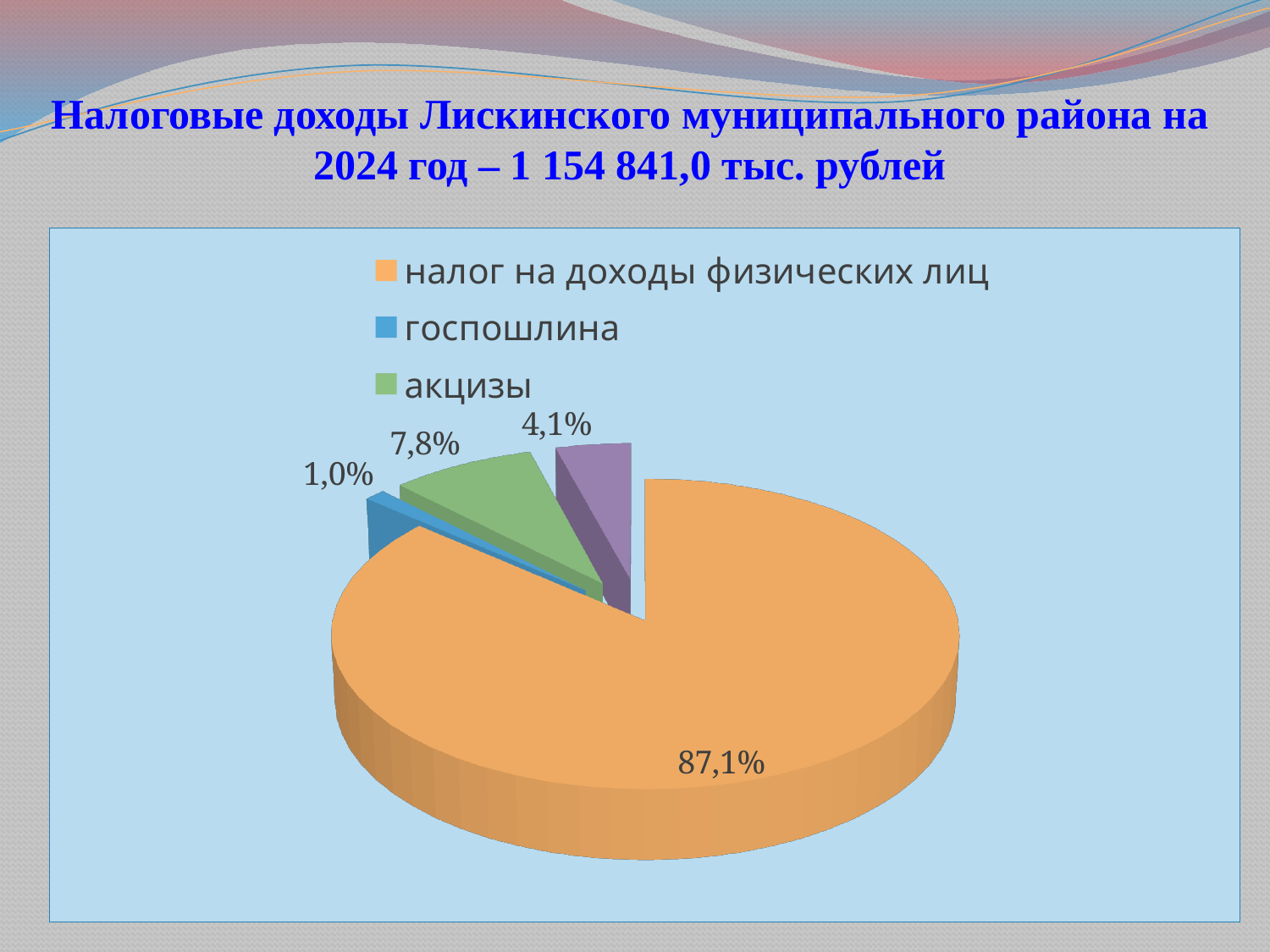
Which category has the smallest slice of the pie? госпошлина Which category has the largest slice of the pie? налог на доходы физических лиц Which is larger, the share for акцизы or the share for госпошлина? акцизы How many slices does the pie chart have? 4 What share of the pie does госпошлина have? 1,0% What share of the pie does акцизы have? 7,8% What kind of chart is shown on the slide? pie chart How many entries does the legend list? 3 What is the difference in percentage points between the share for налог на доходы физических лиц and the share for акцизы? 79,3 What is the difference in percentage points between the share for акцизы and the share for госпошлина? 6,8 What total amount of tax revenue for 2024 is stated in the slide title? 1 154 841,0 тыс. рублей What share of the pie does налог на доходы физических лиц have? 87,1%